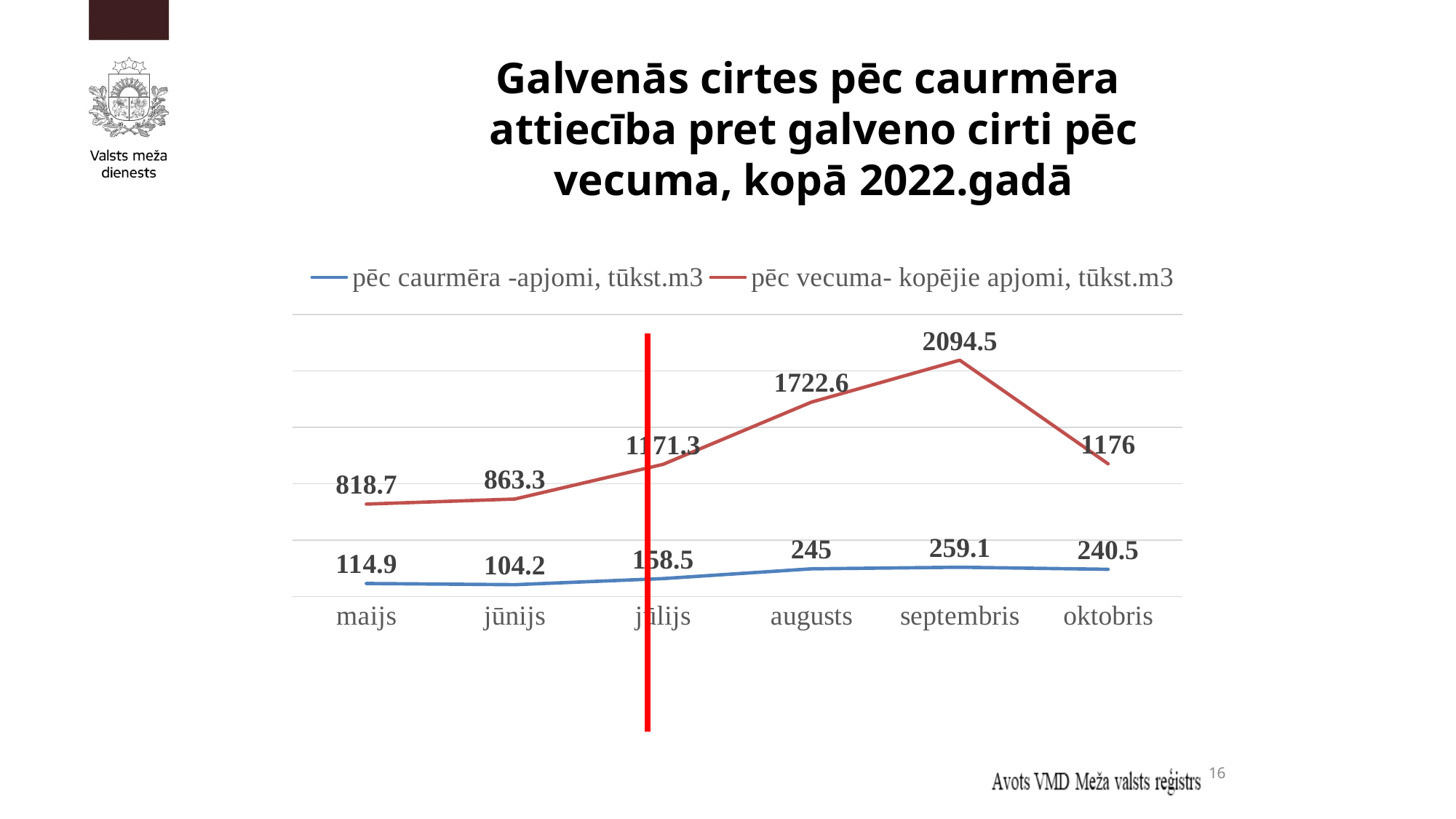
What is the value of the 'pēc caurmēra -apjomi, tūkst.m3' series for oktobris? 240.5 How many series does the chart legend list? 2 What is the difference between the 'pēc caurmēra -apjomi, tūkst.m3' values for septembris and augusts? 14.1 What is the value of the 'pēc vecuma- kopējie apjomi, tūkst.m3' series for septembris? 2094.5 In which month is the 'pēc caurmēra -apjomi, tūkst.m3' series lowest? jūnijs In which month is the 'pēc vecuma- kopējie apjomi, tūkst.m3' series highest? septembris What is the value of the 'pēc caurmēra -apjomi, tūkst.m3' series for maijs? 114.9 For the 'pēc caurmēra -apjomi, tūkst.m3' series, which is larger: augusts or oktobris? augusts What is the difference between the 'pēc vecuma- kopējie apjomi, tūkst.m3' values for augusts and maijs? 903.9 What kind of chart is shown on the slide? line chart Does the 'pēc vecuma- kopējie apjomi, tūkst.m3' series rise or fall from maijs to septembris? rise How many months are shown on the x axis of the chart? 6